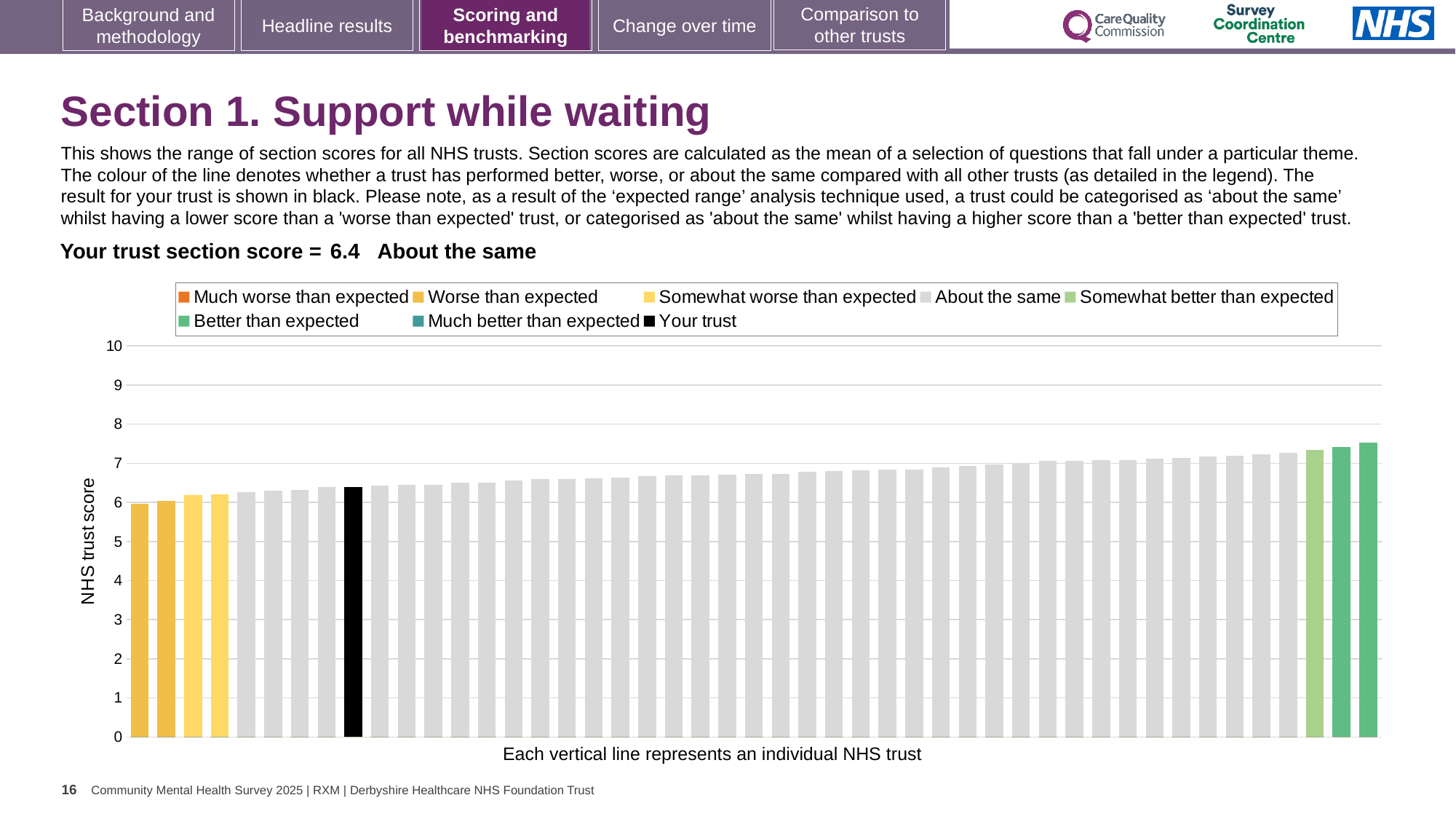
How many entries does the chart legend list? 8 Is the value for your trust (the black bar) greater or less than 6? greater How many bars are coloured as 'Better than expected' (green)? 2 Is the value for your trust (the black bar) greater or less than 7? less What is the label on the y axis of the chart? NHS trust score Which category is your trust placed in for this section? About the same Is the highest bar in the chart greater or less than 7? greater What is the section score for your trust shown on the slide? 6.4 Do the bar values rise or fall from left to right along the x axis? rise What colour is the bar representing your trust? black What kind of chart is shown on the slide? bar chart